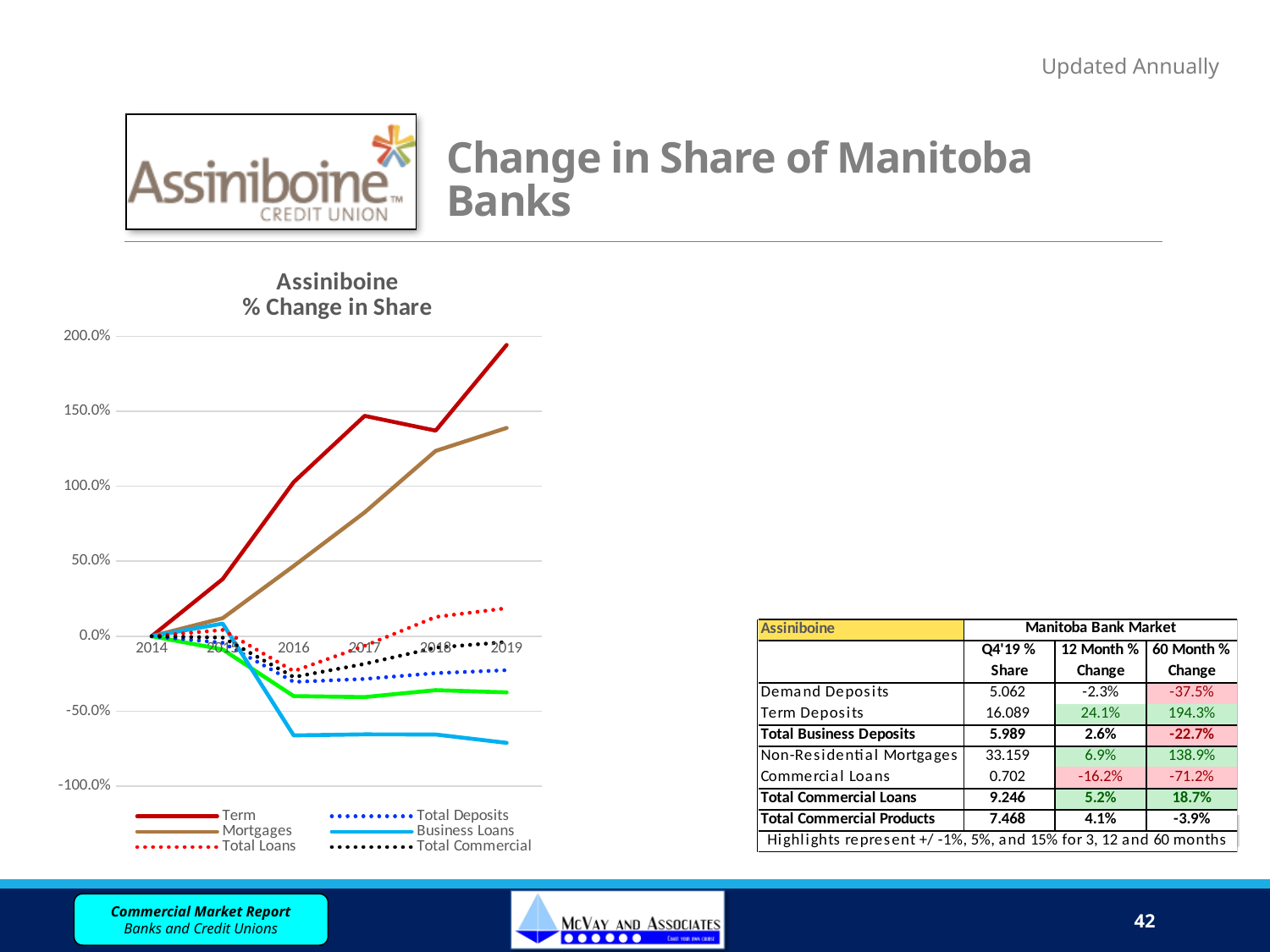
Does the Term series generally rise or fall from 2014 to 2019? rise Is the value for Mortgages in 2019 greater or less than 100.0%? greater What kind of chart is shown on the slide? line chart In 2019, which is larger: the value for Term or the value for Mortgages? Term Is the value for Term in 2019 greater or less than 150.0%? greater Is the value for Business Loans in 2019 greater or less than -50.0%? less How many years are plotted along the x axis of the chart? 6 Which series has the highest value in 2019? Term What is the title of the chart? Assiniboine % Change in Share How many series does the legend of the chart list? 6 Which series has the lowest value in 2019? Business Loans